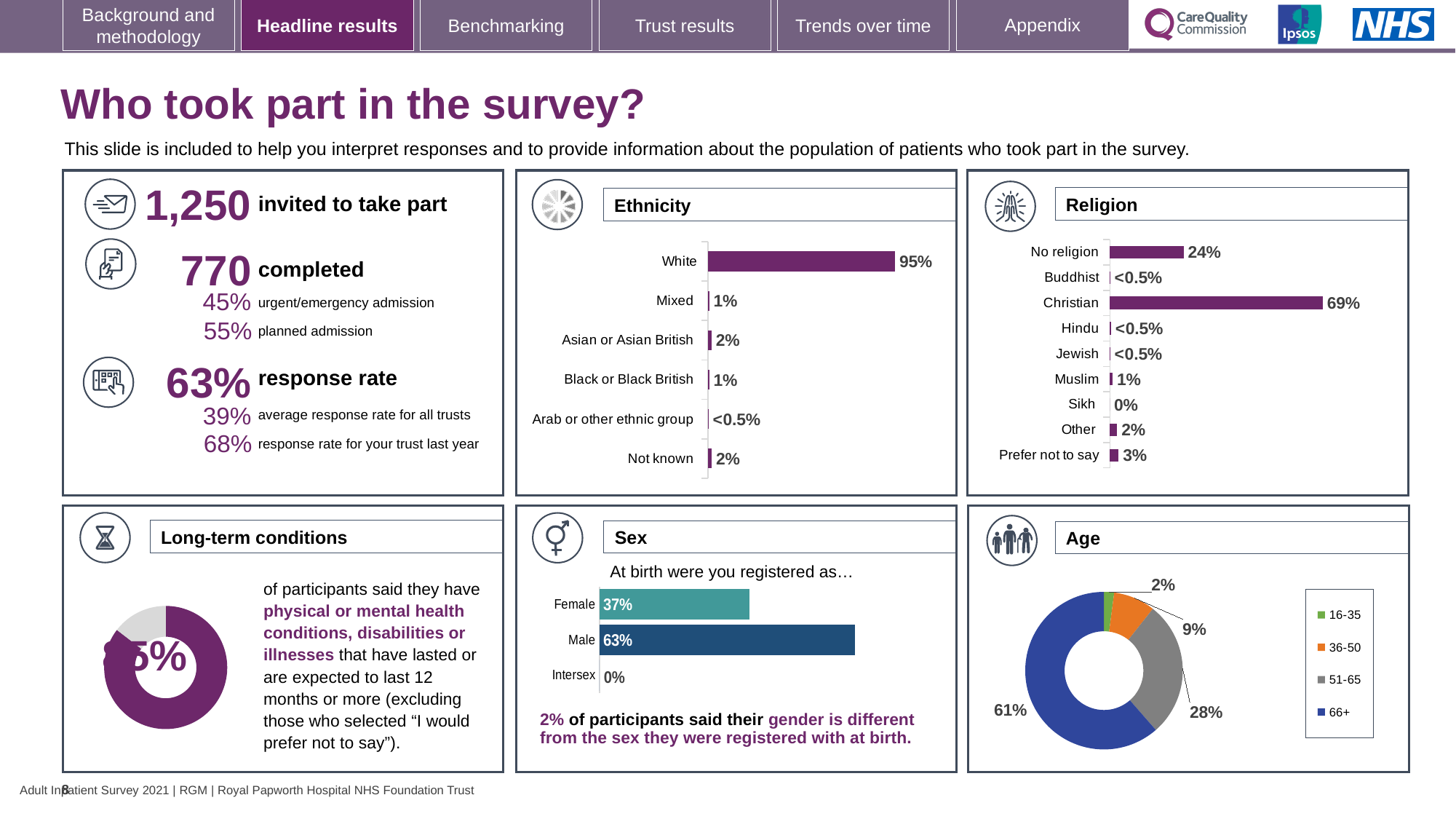
How many age groups does the legend of the Age chart list? 4 In the Ethnicity chart, what percentage of participants were White? 95% In the Religion chart, which religion category has the highest percentage? Christian In the Religion chart, what percentage of participants selected Prefer not to say? 3% How many ethnicity categories are shown in the Ethnicity chart? 6 What kind of chart is the Ethnicity chart? Bar chart In the Sex chart, how many percentage points higher is Male than Female? 26 percentage points In the Religion chart, what percentage of participants reported No religion? 24% In the Age chart, which is larger: the 51-65 group or the 36-50 group? 51-65 In the Age chart, what share of participants were aged 66+? 61% In the Religion chart, what is the difference in percentage points between Christian and No religion? 45 percentage points In the Sex chart, what percentage of participants were registered as Male at birth? 63%